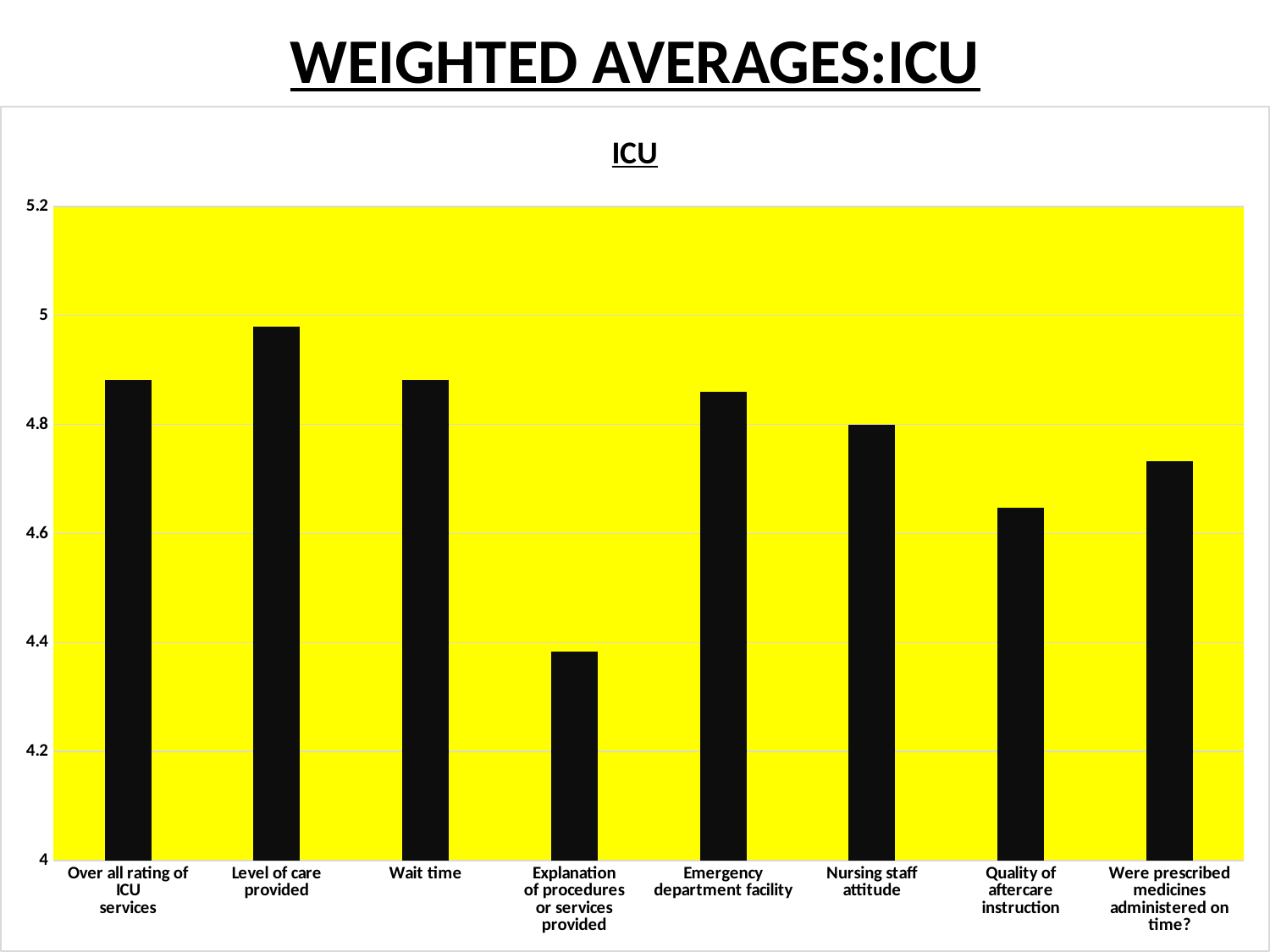
Is the value for Were prescribed medicines administered on time? greater or less than 4.8? less How many categories are plotted on the chart? 8 What is the title shown above the chart's plot area? ICU What kind of chart is shown on the slide? bar chart Which is larger, the value for Level of care provided or the value for Quality of aftercare instruction? Level of care provided Which category has the highest weighted average? Level of care provided Is the value for Explanation of procedures or services provided greater or less than 4.4? less Is the value for Level of care provided greater or less than 5? less Which category has the lowest weighted average? Explanation of procedures or services provided Which is larger, the value for Explanation of procedures or services provided or the value for Nursing staff attitude? Nursing staff attitude